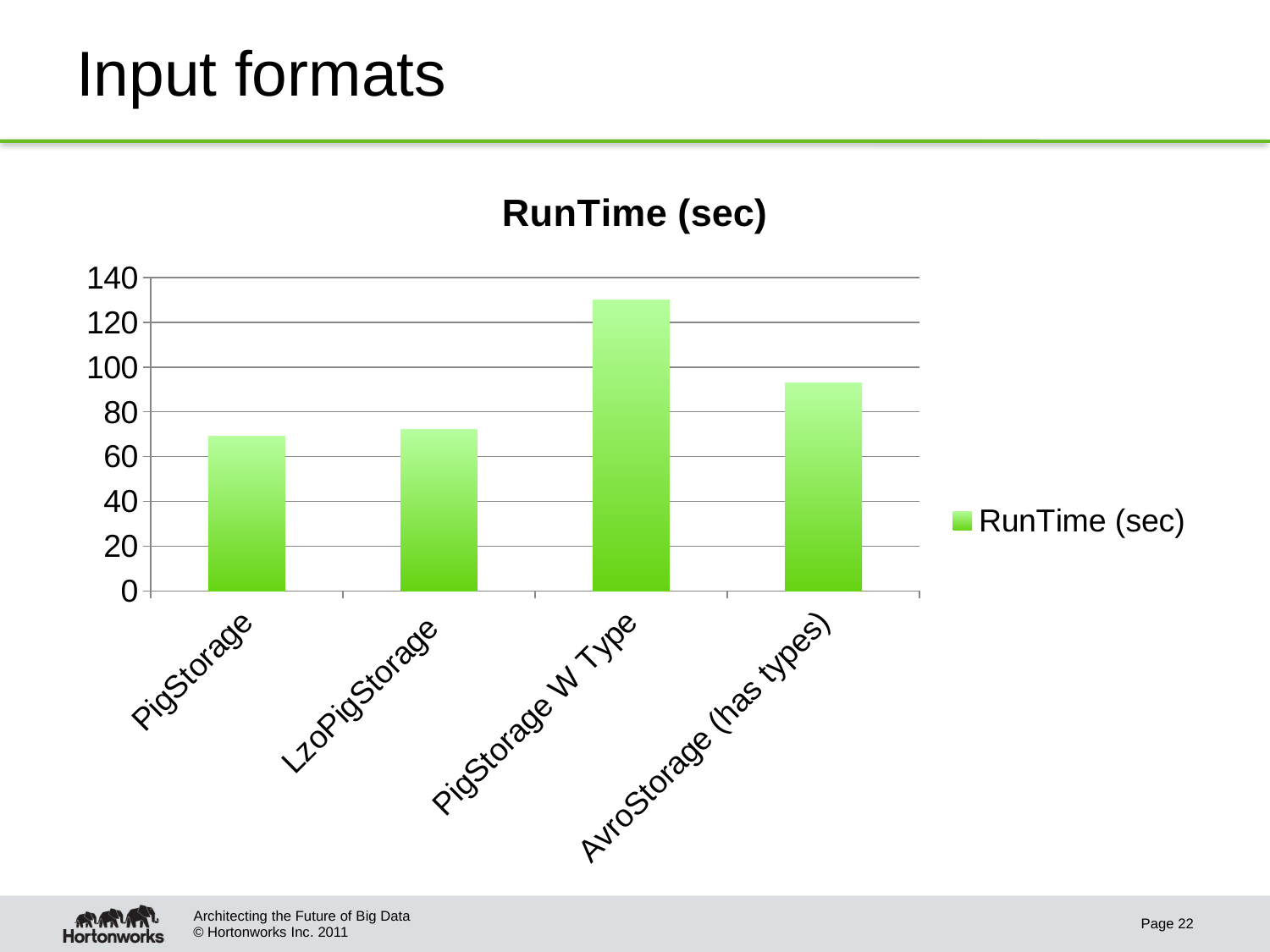
Is the value for PigStorage greater or less than 60? greater How many categories are plotted on the x axis? 4 What is the name of the series shown in the legend? RunTime (sec) Which is larger, the value for AvroStorage (has types) or the value for PigStorage? AvroStorage (has types) Which is larger, the value for PigStorage W Type or the value for AvroStorage (has types)? PigStorage W Type What is the title of the chart? RunTime (sec) Is the value for PigStorage W Type greater or less than 120? greater Is the value for AvroStorage (has types) greater or less than 100? less How many series does the legend list? 1 What kind of chart is shown on the slide? bar chart Which category has the highest RunTime (sec)? PigStorage W Type